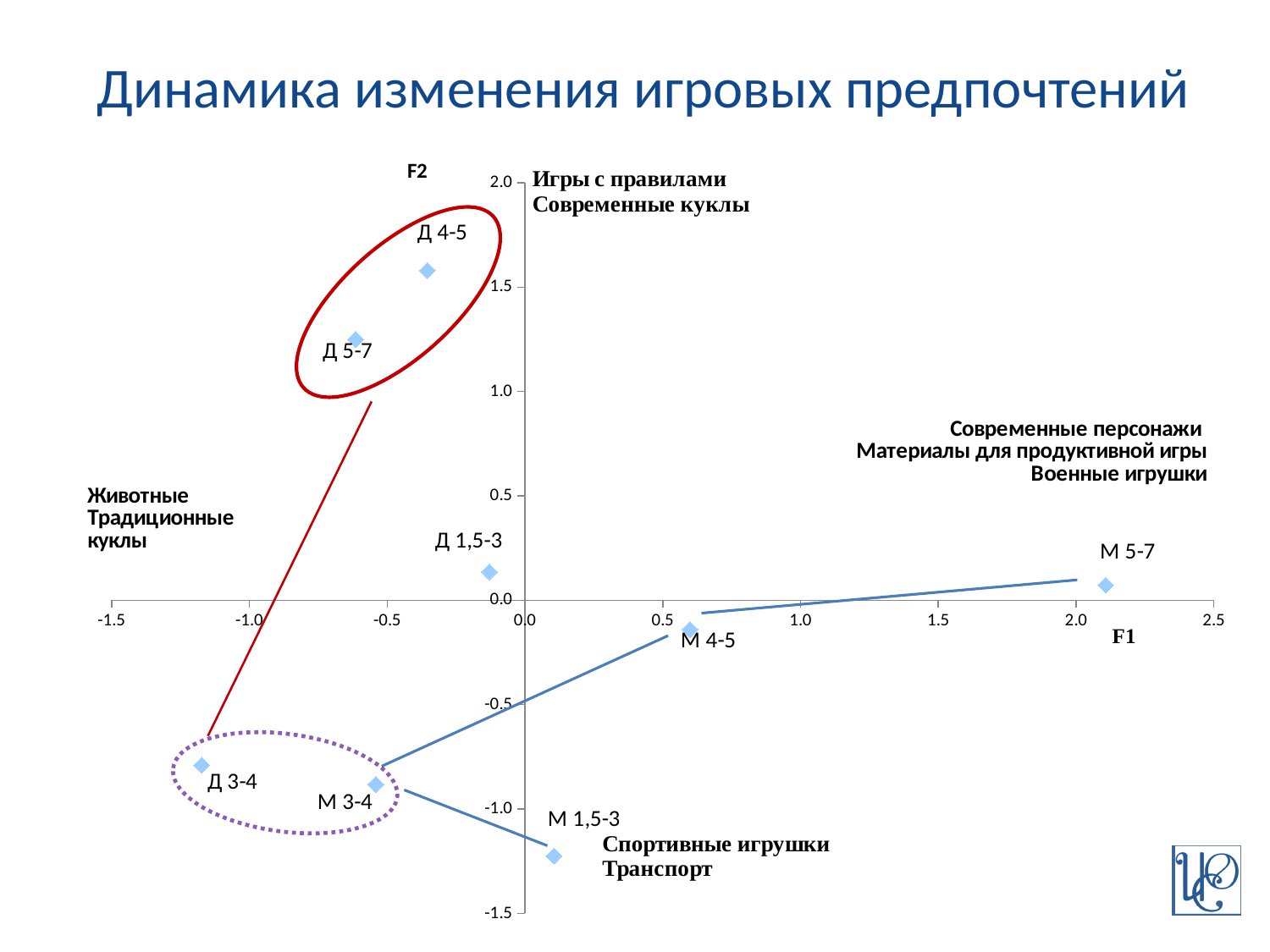
Is the F2 value for М 1,5-3 greater or less than -1.0? less Which data point has the highest F1 value? М 5-7 How many labelled data points are plotted on the chart? 8 What are the labels of the horizontal and vertical axes? F1 and F2 What kind of chart is shown on the slide? scatter chart Which has the higher F2 value, Д 4-5 or Д 5-7? Д 4-5 Is the F2 value for Д 5-7 greater or less than 1.0? greater Which data point has the lowest F2 value? М 1,5-3 Which data point has the lowest F1 value? Д 3-4 Is the F1 value for М 5-7 greater or less than 2.0? greater Which data point has the highest F2 value? Д 4-5 What is the title of the slide's chart? Динамика изменения игровых предпочтений